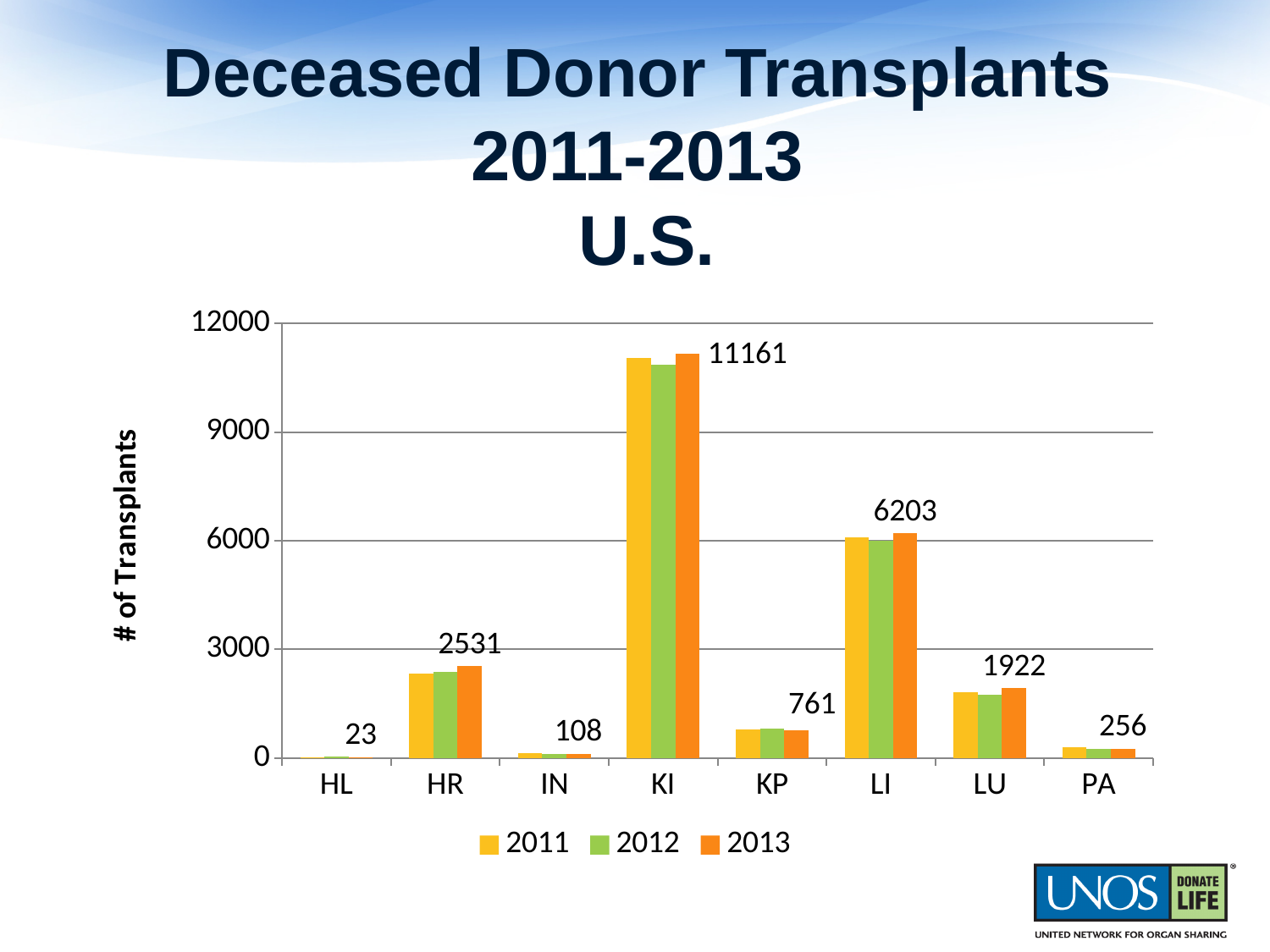
In 2013, which had more transplants, LI or LU? LI What is the title of the y axis? # of Transplants Which organ category has the lowest number of transplants? HL How many organ categories are shown on the x axis? 8 How many series does the legend list? 3 Is the value for KI in 2011 greater or less than 9000? greater Which organ category has the highest number of transplants? KI What kind of chart is shown on the slide? bar chart What is the value for HR in 2013? 2531 What is the difference between the 2013 values for KI and LI? 4958 What is the value for LI in 2013? 6203 What is the number of deceased donor transplants for KI in 2013? 11161